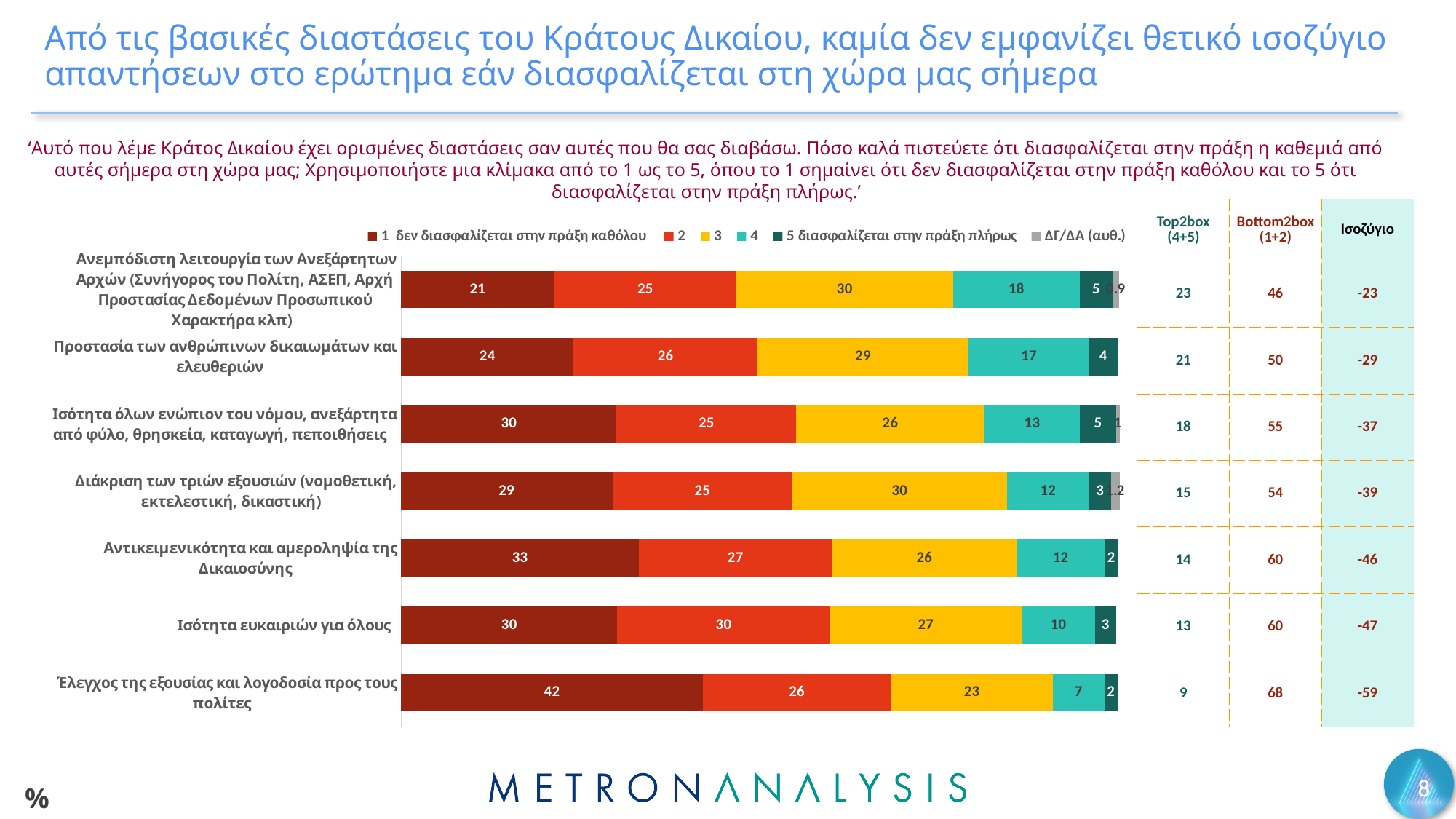
What is the difference between the series '2' values for 'Ισότητα ευκαιριών για όλους' and 'Ισότητα όλων ενώπιον του νόμου'? 5 What is the Top2box (4+5) value shown for 'Προστασία των ανθρώπινων δικαιωμάτων και ελευθεριών'? 21 What is the value of series '3' for 'Προστασία των ανθρώπινων δικαιωμάτων και ελευθεριών'? 29 Which is larger: the series '4' value for 'Ανεμπόδιστη λειτουργία των Ανεξάρτητων Αρχών' or for 'Αντικειμενικότητα και αμεροληψία της Δικαιοσύνης'? Ανεμπόδιστη λειτουργία των Ανεξάρτητων Αρχών How many series does the legend list? 6 How many categories (rows) does the chart show? 7 What is the value of series '1 δεν διασφαλίζεται στην πράξη καθόλου' for 'Έλεγχος της εξουσίας και λογοδοσία προς τους πολίτες'? 42 What is the Ισοζύγιο value shown for 'Έλεγχος της εξουσίας και λογοδοσία προς τους πολίτες'? -59 What kind of chart is shown on the slide? Stacked bar chart Which category has the lowest value for series '1 δεν διασφαλίζεται στην πράξη καθόλου'? Ανεμπόδιστη λειτουργία των Ανεξάρτητων Αρχών Which category has the highest value for series '1 δεν διασφαλίζεται στην πράξη καθόλου'? Έλεγχος της εξουσίας και λογοδοσία προς τους πολίτες What is the value of series '4' for 'Ισότητα ευκαιριών για όλους'? 10